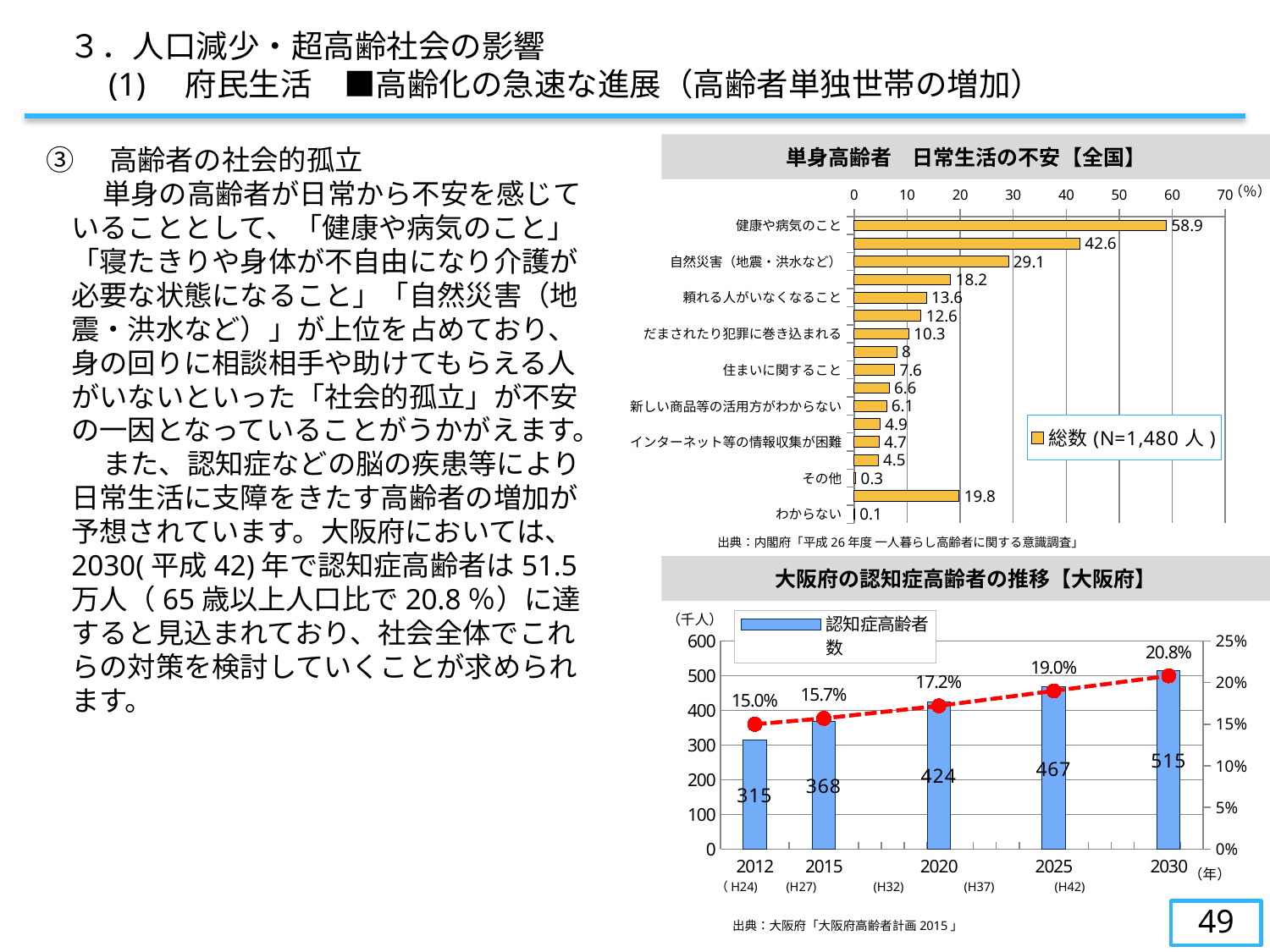
In the chart 大阪府の認知症高齢者の推移【大阪府】, what percentage is shown for 2020? 17.2% In the chart 大阪府の認知症高齢者の推移【大阪府】, how many years are plotted on the x axis? 5 In the chart 単身高齢者 日常生活の不安【全国】, what is the N shown in the legend? N=1,480 人 What kind of chart is 単身高齢者 日常生活の不安【全国】? bar chart In the chart 単身高齢者 日常生活の不安【全国】, what is the value for 健康や病気のこと? 58.9 In the chart 大阪府の認知症高齢者の推移【大阪府】, do the bar values rise or fall from 2012 to 2030? rise In the chart 単身高齢者 日常生活の不安【全国】, what is the difference between 健康や病気のこと and 自然災害（地震・洪水など）? 29.8 In the chart 大阪府の認知症高齢者の推移【大阪府】, what is the number of 認知症高齢者 (千人) in 2030? 515 In the chart 単身高齢者 日常生活の不安【全国】, which category has the highest value? 健康や病気のこと In the chart 単身高齢者 日常生活の不安【全国】, which category has the lowest value? わからない In the chart 大阪府の認知症高齢者の推移【大阪府】, what is the difference in 認知症高齢者数 between 2030 and 2012? 200 In the chart 単身高齢者 日常生活の不安【全国】, what is the value for 自然災害（地震・洪水など）? 29.1